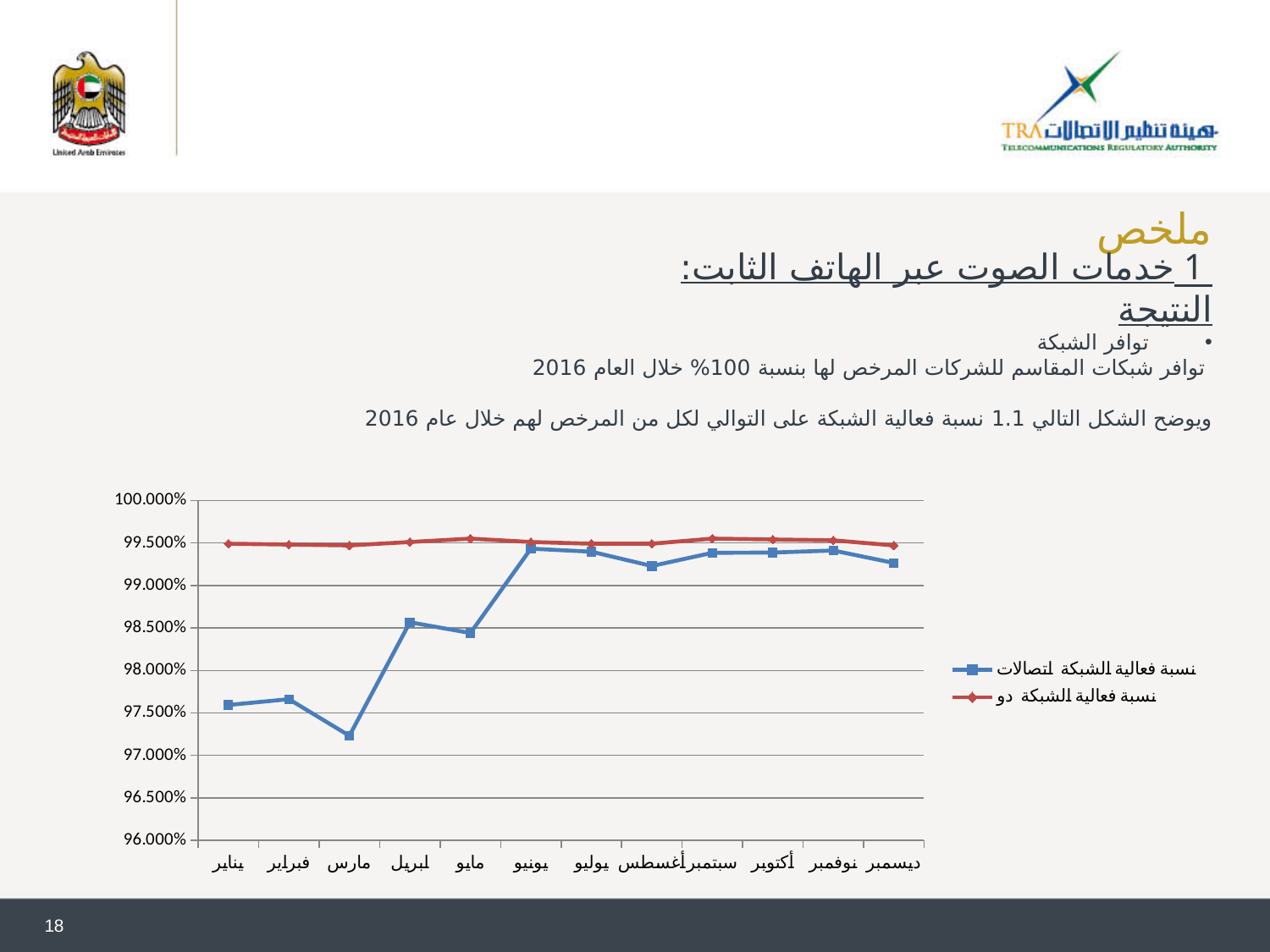
Is the value for نسبة فعالية الشبكة اتصالات in أغسطس greater or less than 99.000%? greater In which month is the value for نسبة فعالية الشبكة اتصالات lowest? مارس How many series does the legend list? 2 In يناير, which series has the higher value: نسبة فعالية الشبكة اتصالات or نسبة فعالية الشبكة دو? نسبة فعالية الشبكة دو Is the value for نسبة فعالية الشبكة اتصالات in يونيو greater or less than 99.000%? greater Does the value for نسبة فعالية الشبكة اتصالات rise or fall from مارس to يونيو? rise What kind of chart is shown on the slide? line chart Which colour is used for the نسبة فعالية الشبكة دو series? red Is the value for نسبة فعالية الشبكة دو in يناير greater or less than 99.000%? greater How many months are plotted along the x axis? 12